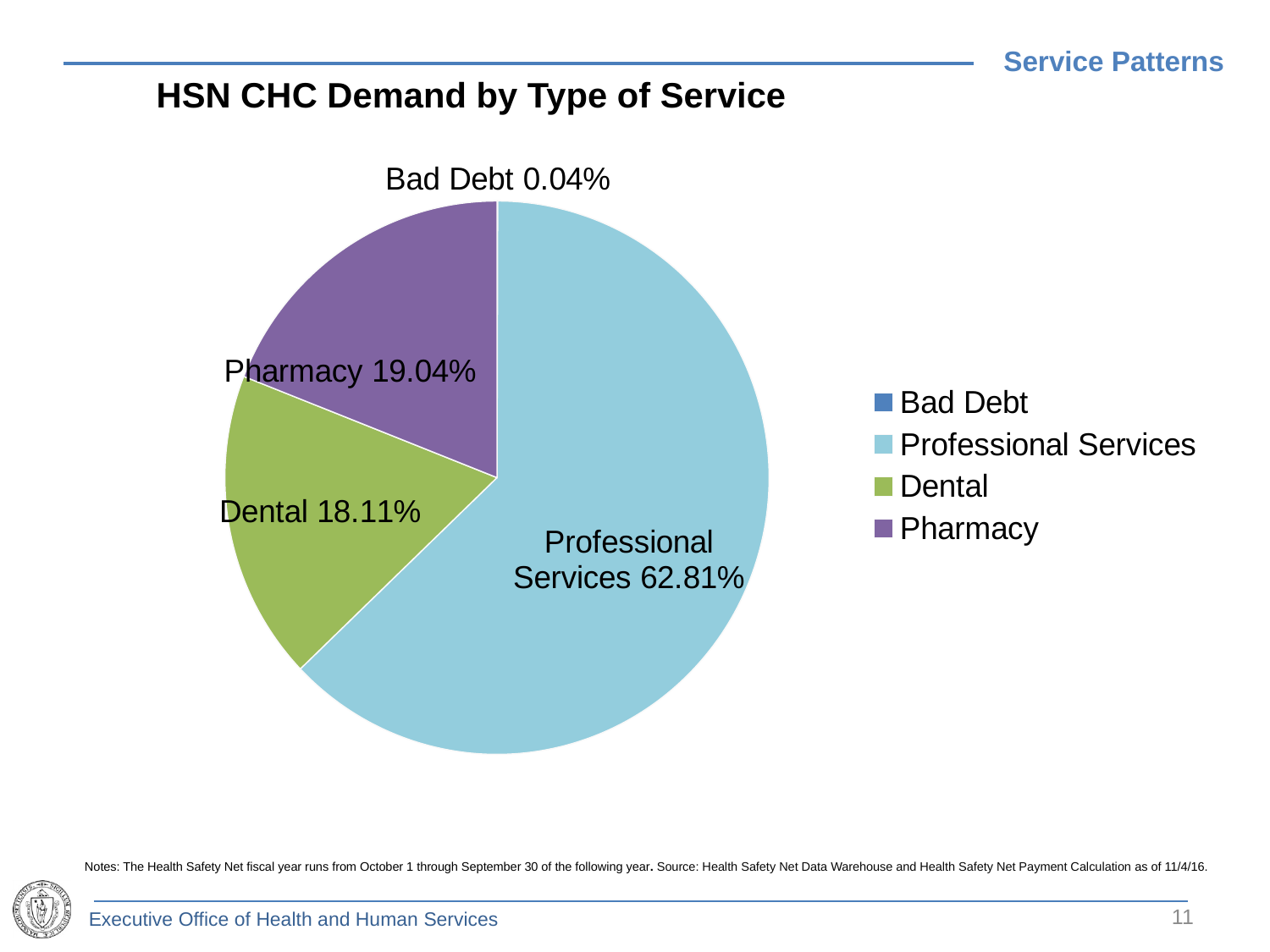
What kind of chart is shown on the slide? Pie chart What share of HSN CHC demand is Bad Debt? 0.04% Which has a larger share of HSN CHC demand, Dental or Professional Services? Professional Services What is the title of the chart? HSN CHC Demand by Type of Service What share of HSN CHC demand is Professional Services? 62.81% Which type of service has the largest share of HSN CHC demand? Professional Services What is the difference in percentage points between the Professional Services and Pharmacy shares? 43.77 What share of HSN CHC demand is Pharmacy? 19.04% What is the difference in percentage points between the Pharmacy and Dental shares? 0.93 What share of HSN CHC demand is Dental? 18.11% How many types of service are shown in the pie chart? 4 Which type of service has the smallest share of HSN CHC demand? Bad Debt